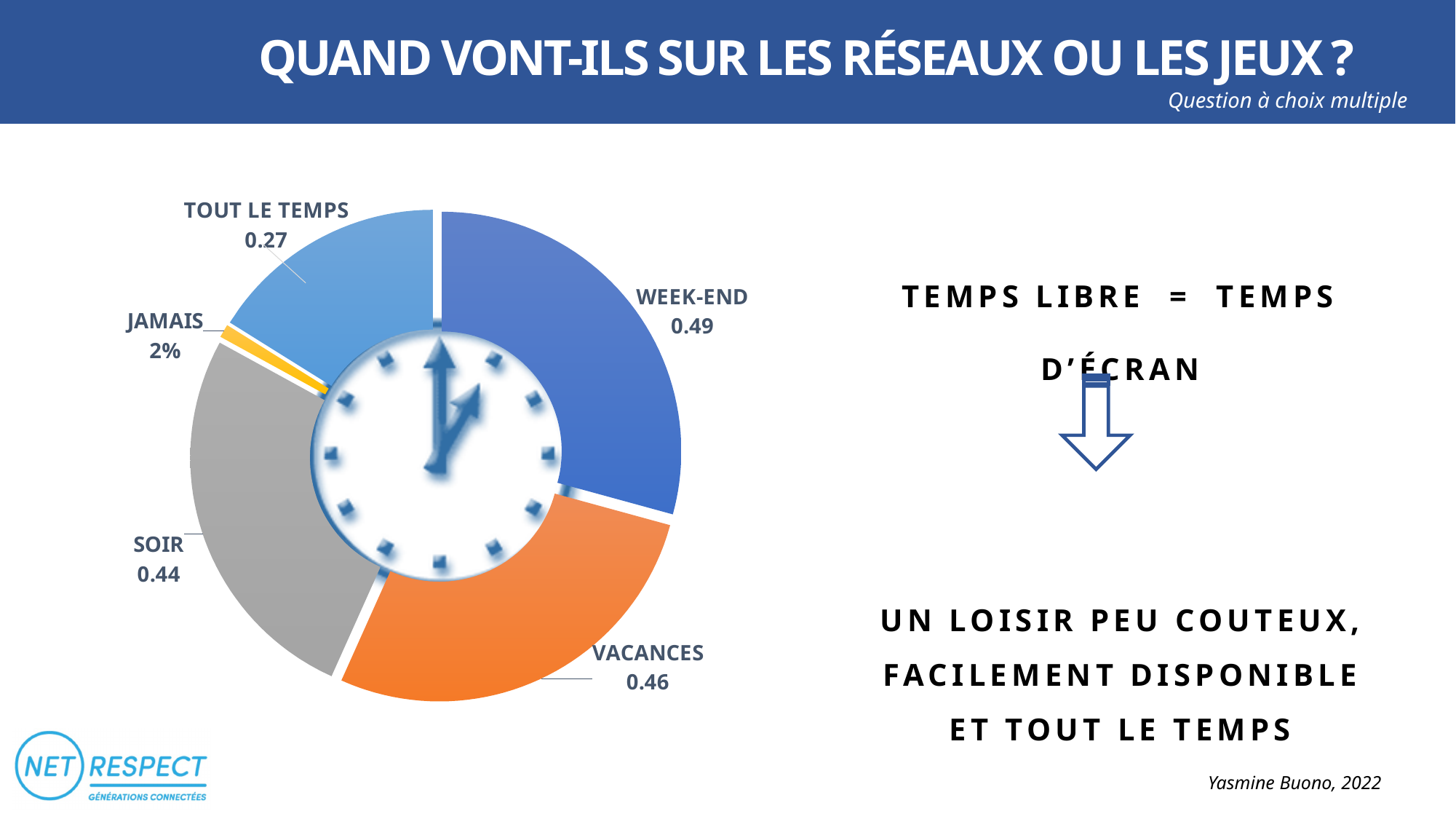
Which category has the lowest value? JAMAIS What is the difference between the values for VACANCES and TOUT LE TEMPS? 0.19 Which has a larger value, WEEK-END or VACANCES? WEEK-END Which category has the highest value? WEEK-END What value is shown for TOUT LE TEMPS? 0.27 What value is shown for WEEK-END? 0.49 What kind of chart is shown on the slide? Doughnut (pie) chart What value is shown for VACANCES? 0.46 What is the difference between the values for WEEK-END and SOIR? 0.05 What value is shown for SOIR? 0.44 What value is shown for JAMAIS? 2% How many categories are shown in the chart? 5